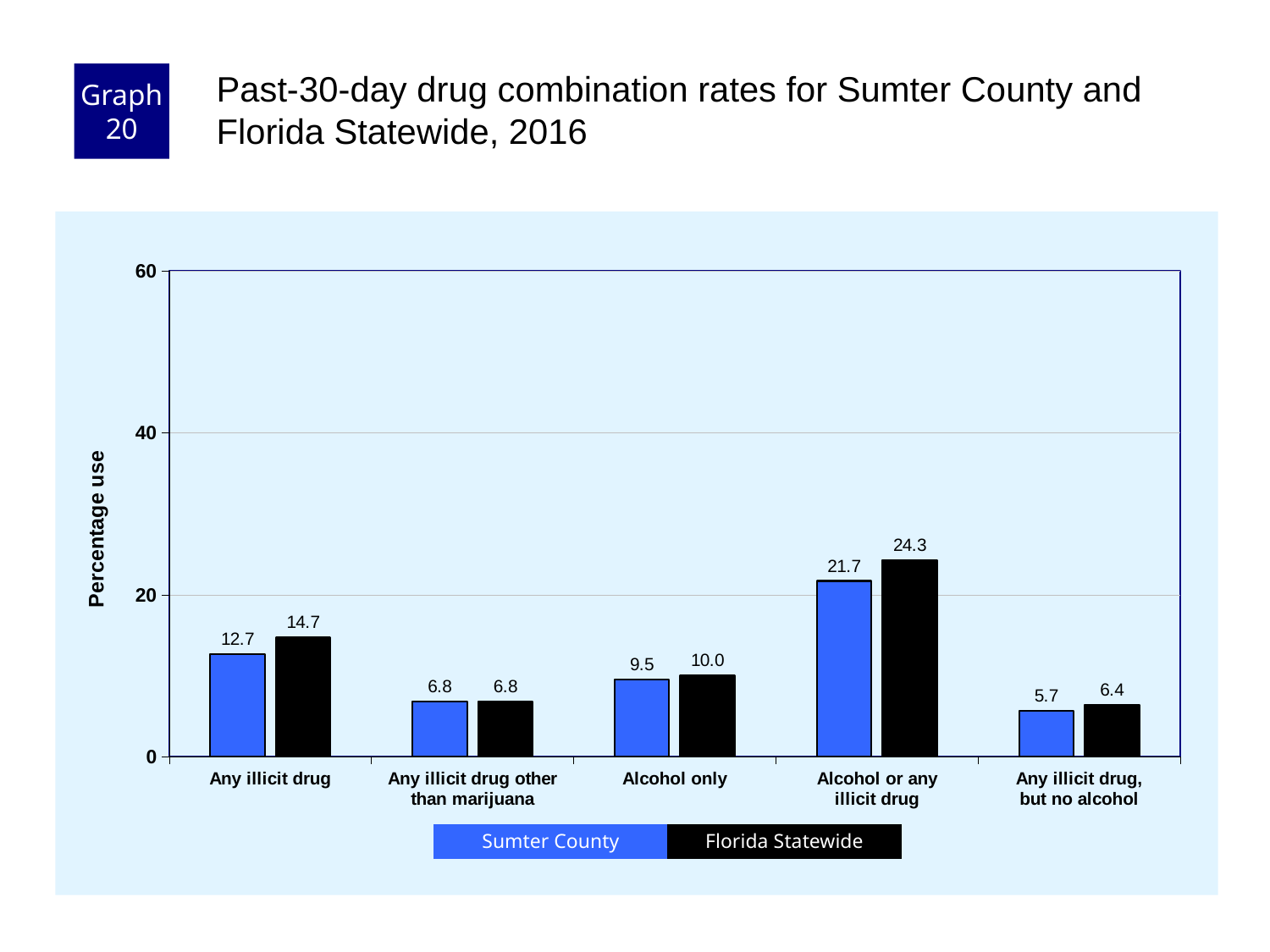
What is the difference between the Florida Statewide and Sumter County values for Any illicit drug? 2.0 What is the difference between the Florida Statewide and Sumter County values for Alcohol or any illicit drug? 2.6 How many series does the legend list? 2 Which category has the highest Sumter County value? Alcohol or any illicit drug What kind of chart is shown on the slide? Bar chart Is the Florida Statewide value for Alcohol or any illicit drug greater or less than 20? greater What is the Sumter County value for Any illicit drug? 12.7 What is the Florida Statewide value for Any illicit drug, but no alcohol? 6.4 What is the Florida Statewide value for Alcohol or any illicit drug? 24.3 Which is larger for Alcohol only: the Sumter County value or the Florida Statewide value? Florida Statewide Which category has the lowest Florida Statewide value? Any illicit drug, but no alcohol How many categories are shown on the x axis? 5